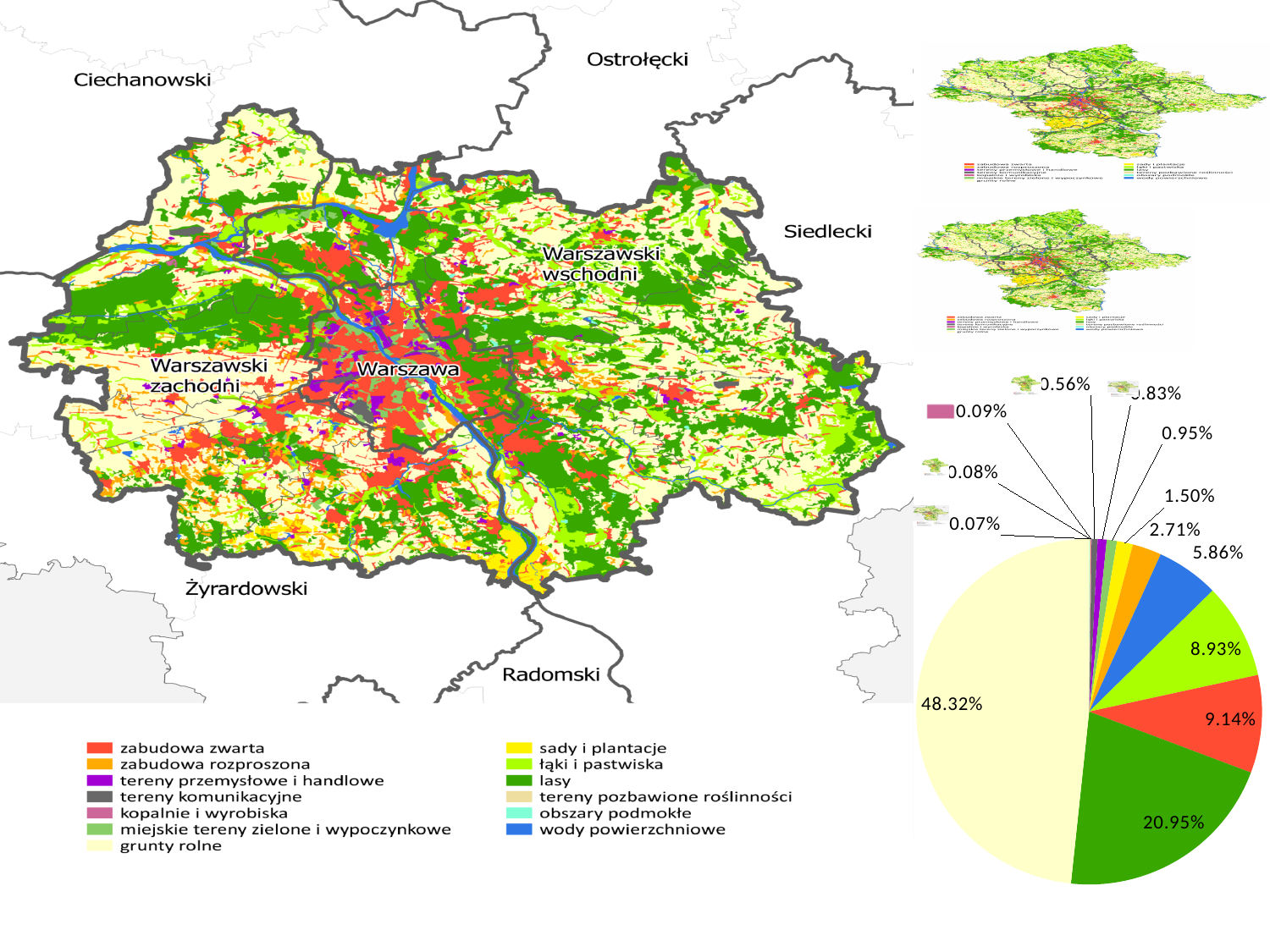
What is the combined share of the two largest slices (48.32% and 20.95%) in the pie chart? 69.27% What is the difference between the 9.14% slice and the 8.93% slice in the pie chart? 0.21% What is the difference between the largest slice (48.32%) and the second-largest slice (20.95%) in the pie chart? 27.37% What colour is the largest slice of the pie chart? pale yellow What is the value of the second-largest slice in the pie chart? 20.95% In the pie chart, which is larger: the red slice at 9.14% or the light green slice at 8.93%? 9.14% How many slices are labelled with percentages in the pie chart? 13 What is the value of the smallest slice labelled in the pie chart? 0.07% What kind of chart is shown on the right side of the slide? pie chart What is the value of the blue slice in the pie chart? 5.86% Is the largest slice of the pie chart greater or less than 50%? less What is the value of the largest slice in the pie chart? 48.32%